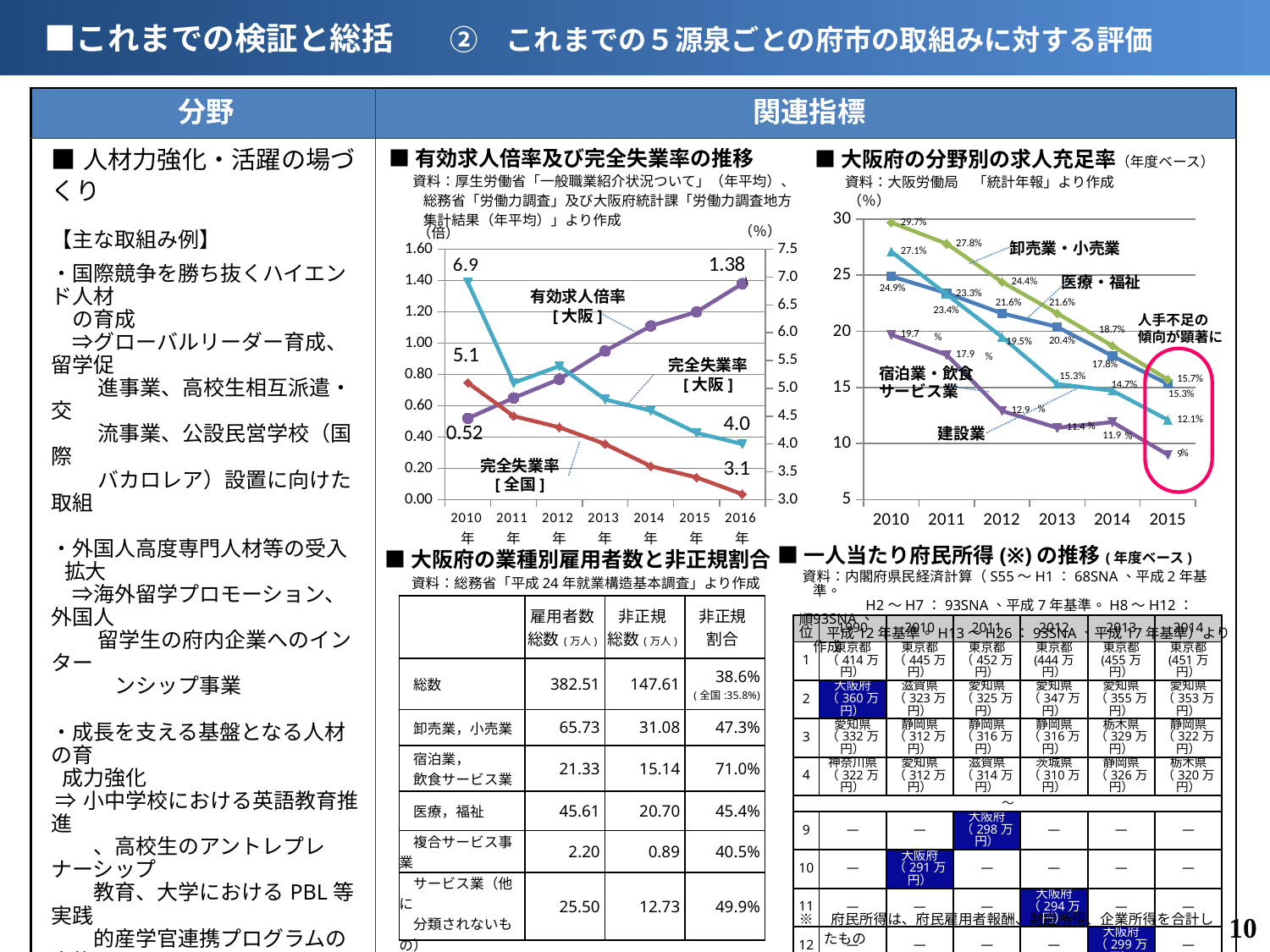
In the chart titled 大阪府の分野別の求人充足率, what is the highest value shown for 2010? 29.7% In the chart titled 大阪府の分野別の求人充足率, do the values generally rise or fall from 2010 to 2015? fall In the chart titled 大阪府の分野別の求人充足率, how many industry series are plotted? 4 What kind of chart is the one titled 大阪府の分野別の求人充足率? line chart In the chart titled 有効求人倍率及び完全失業率の推移, does 有効求人倍率[大阪] rise or fall from 2010 to 2016? rise In the chart titled 有効求人倍率及び完全失業率の推移, what is the value of 有効求人倍率[大阪] in 2010? 0.52 In the chart titled 有効求人倍率及び完全失業率の推移, what is the value of 完全失業率[大阪] in 2010? 6.9 In the chart titled 有効求人倍率及び完全失業率の推移, what is the value of 有効求人倍率[大阪] in 2016? 1.38 In the chart titled 有効求人倍率及び完全失業率の推移, what is the difference between 完全失業率[大阪] and 完全失業率[全国] in 2010? 1.8 In the chart titled 有効求人倍率及び完全失業率の推移, how many years are shown on the x axis? 7 In the chart titled 有効求人倍率及び完全失業率の推移, what is the value of 完全失業率[全国] in 2016? 3.1 In the chart titled 有効求人倍率及び完全失業率の推移, by how much did 有効求人倍率[大阪] increase from 2010 to 2016? 0.86